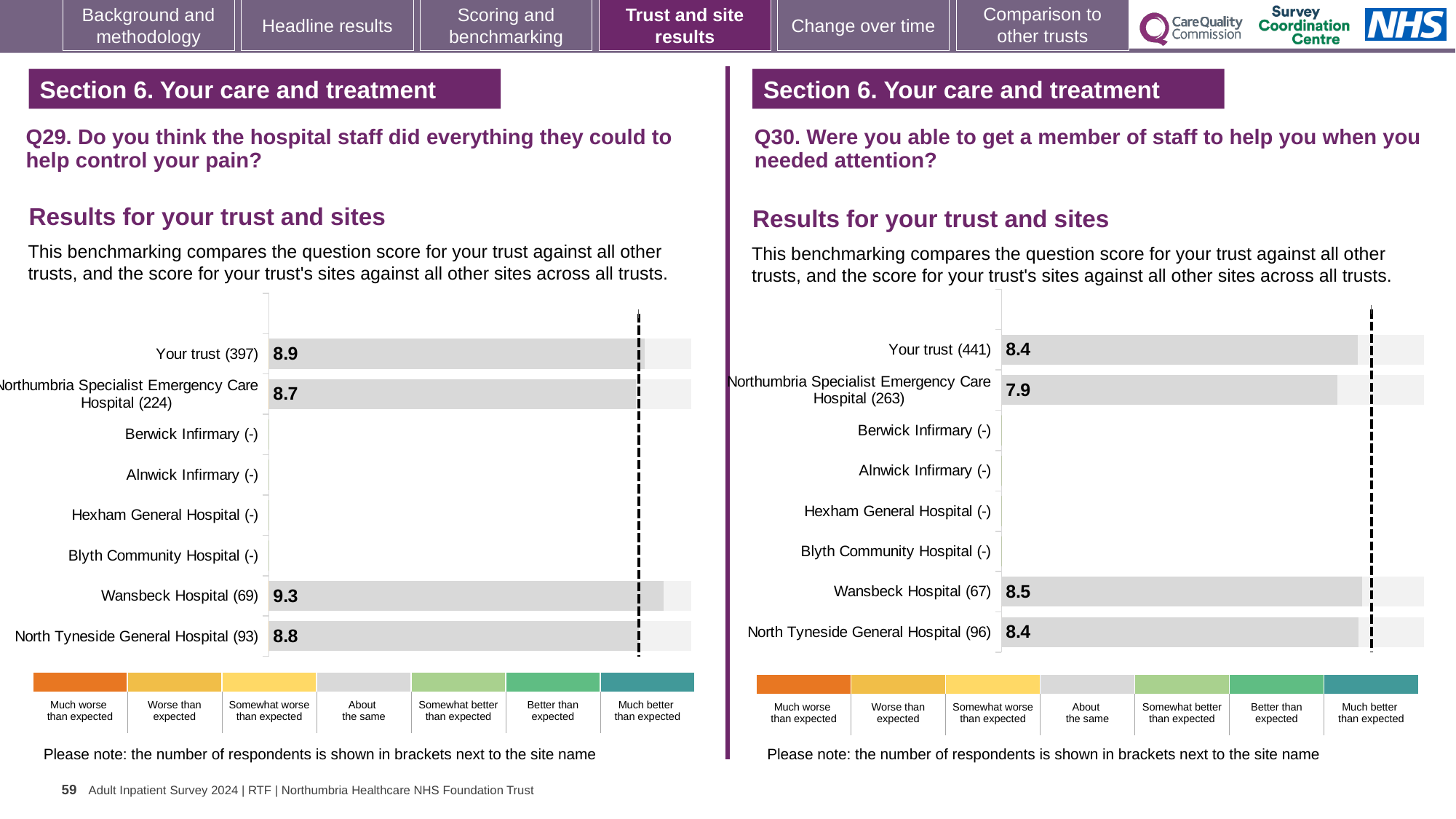
On the Q30 chart (right), which site has the lowest score among those with a score shown? Northumbria Specialist Emergency Care Hospital On the Q29 chart (left), how many respondents are shown for North Tyneside General Hospital? 93 On the Q30 chart (right), what is the difference between the scores for Wansbeck Hospital and Northumbria Specialist Emergency Care Hospital? 0.6 On the Q29 chart (left), which site has the highest score? Wansbeck Hospital What kind of chart is used on the Q30 chart (right)? Bar chart On the Q30 chart (right), which is larger: the score for Wansbeck Hospital or the score for North Tyneside General Hospital? Wansbeck Hospital On the Q30 chart (right), what is the score for Your trust? 8.4 How many site rows (including Your trust) are listed on the Q29 chart (left)? 8 On the Q29 chart (left), what is the score for Your trust? 8.9 On the Q29 chart (left), what is the score for Wansbeck Hospital? 9.3 On the Q30 chart (right), what is the score for Northumbria Specialist Emergency Care Hospital? 7.9 On the Q29 chart (left), what is the difference between the scores for Wansbeck Hospital and Northumbria Specialist Emergency Care Hospital? 0.6